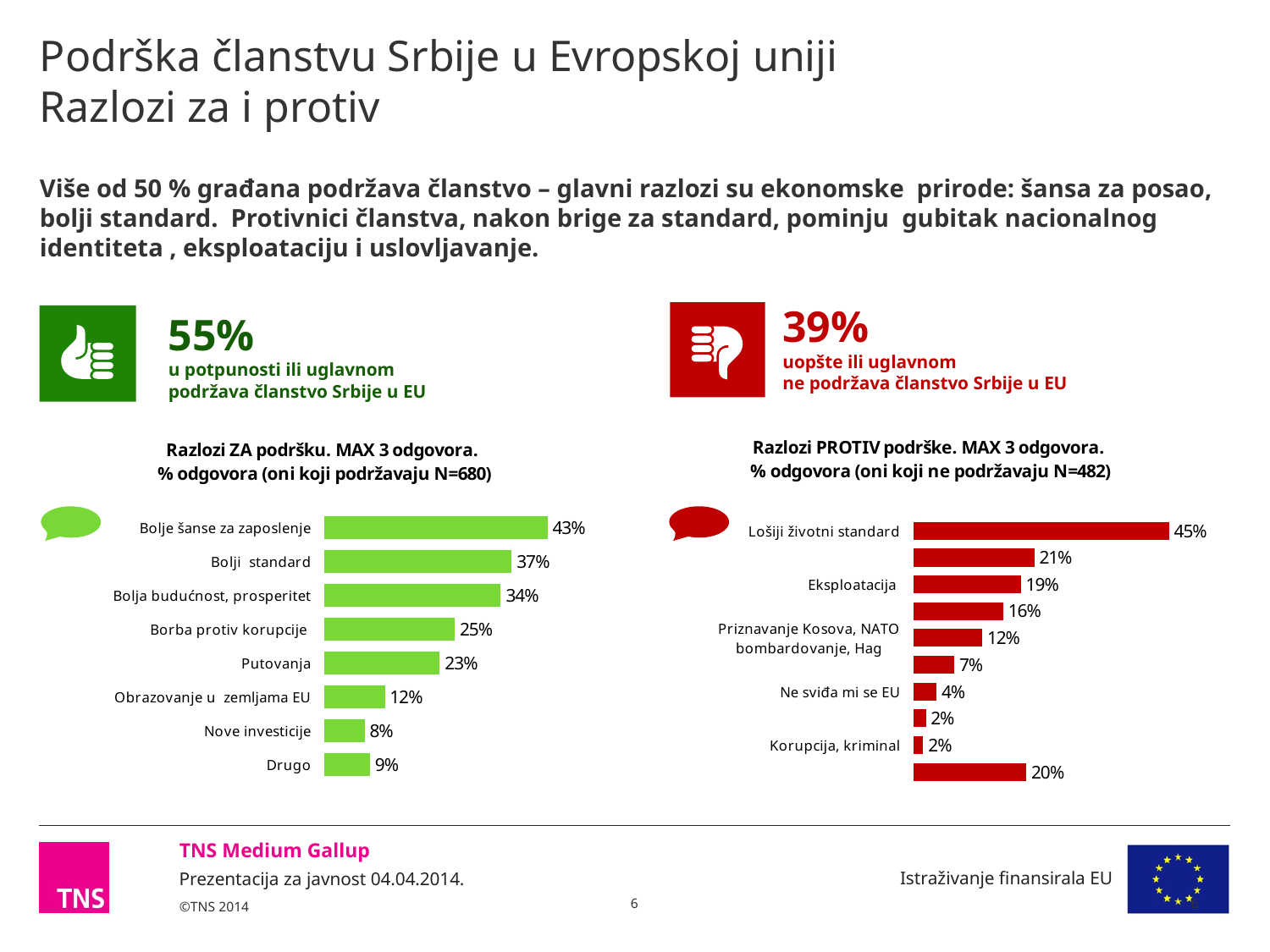
In the chart 'Razlozi PROTIV podrške', what is the value for 'Eksploatacija'? 19% In the chart 'Razlozi ZA podršku', which is larger: 'Drugo' or 'Nove investicije'? Drugo In the chart 'Razlozi PROTIV podrške', what is the value for 'Priznavanje Kosova, NATO bombardovanje, Hag'? 12% In the chart 'Razlozi PROTIV podrške', which category has the highest value? Lošiji životni standard In the chart 'Razlozi ZA podršku', which category has the lowest value? Nove investicije In the chart 'Razlozi ZA podršku', what is the value for 'Putovanja'? 23% What type of chart is 'Razlozi ZA podršku'? Bar chart In the chart 'Razlozi ZA podršku', what is the value for 'Bolje šanse za zaposlenje'? 43% In the chart 'Razlozi ZA podršku', what is the difference between 'Bolji standard' and 'Borba protiv korupcije'? 12% In the chart 'Razlozi PROTIV podrške', what is the difference between 'Eksploatacija' and 'Ne sviđa mi se EU'? 15% How many categories are shown in the chart 'Razlozi ZA podršku'? 8 In the chart 'Razlozi PROTIV podrške', what is the value for 'Lošiji životni standard'? 45%